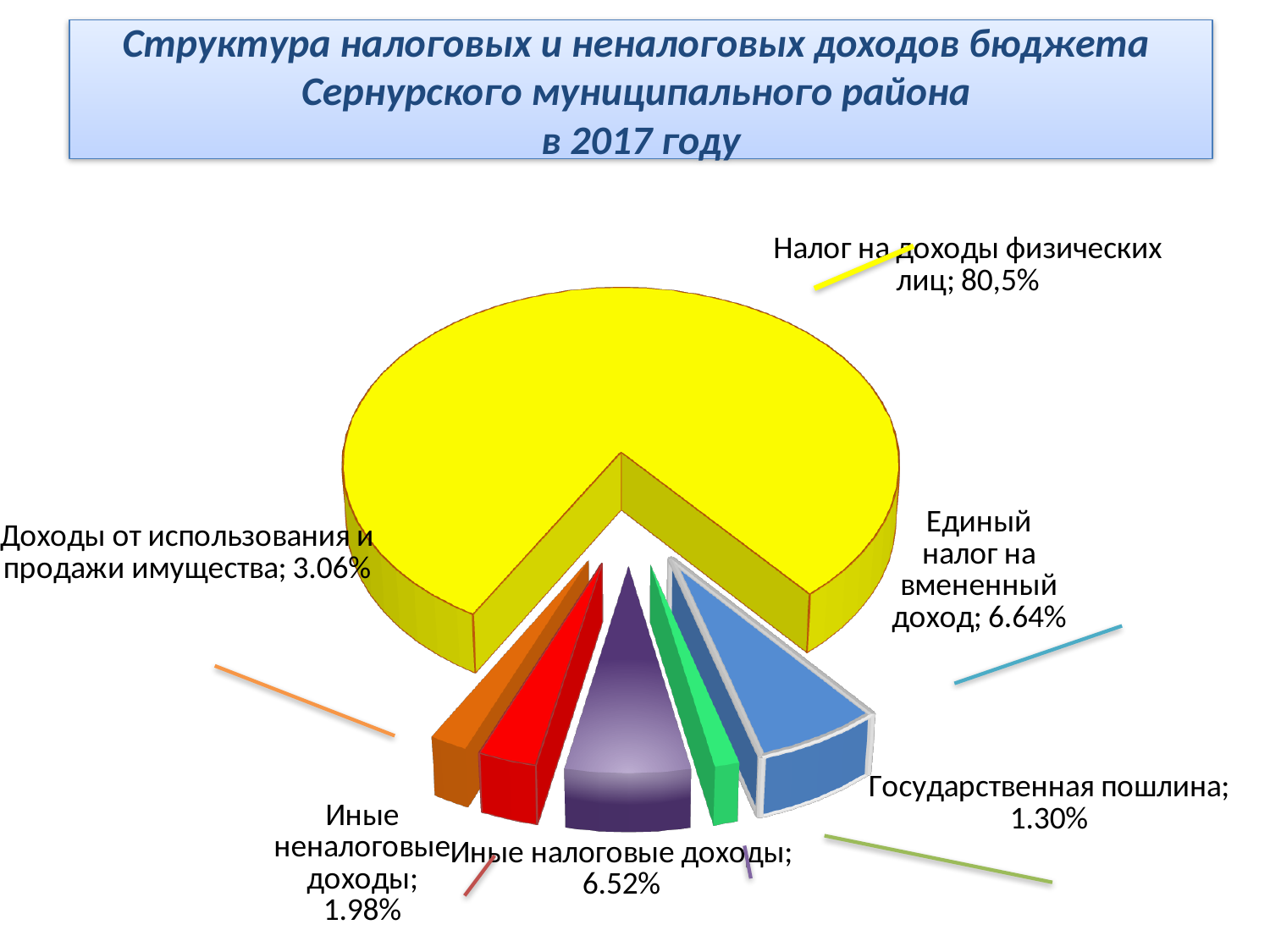
What is the value shown for "Иные неналоговые доходы"? 1.98% What is the value shown for "Доходы от использования и продажи имущества"? 3.06% What share does "Налог на доходы физических лиц" have in the pie chart? 80,5% What kind of chart is shown on the slide? pie chart How many slices does the pie chart have? 6 Which category has the largest share of the pie? Налог на доходы физических лиц Which is larger: "Доходы от использования и продажи имущества" or "Иные неналоговые доходы"? Доходы от использования и продажи имущества What is the value shown for "Государственная пошлина"? 1.30% What is the value shown for "Единый налог на вмененный доход"? 6.64% Which category has the smallest share of the pie? Государственная пошлина What is the difference between the shares of "Доходы от использования и продажи имущества" and "Государственная пошлина"? 1.76% What is the value shown for "Иные налоговые доходы"? 6.52%